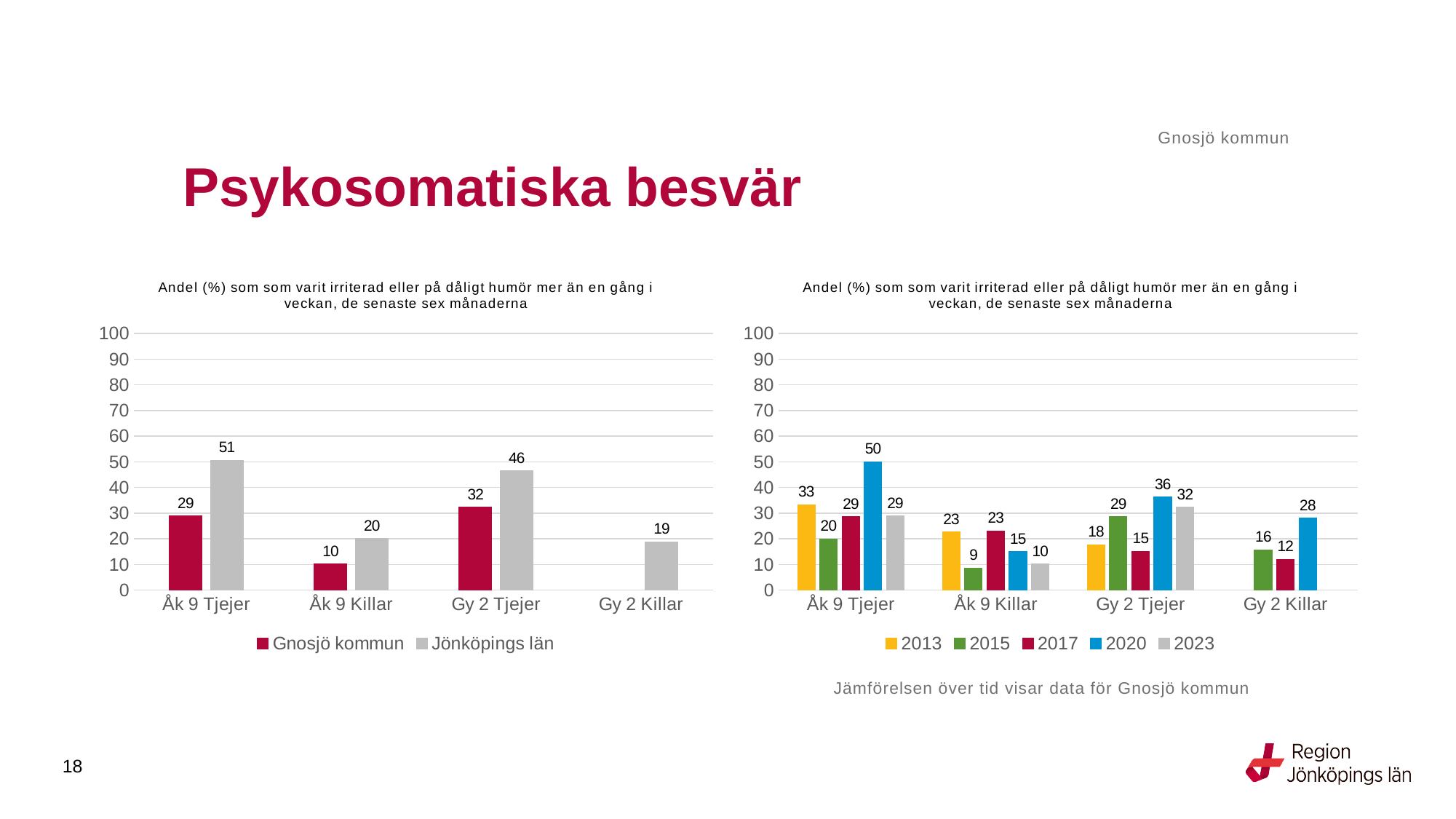
In the left chart, which category has the highest value for Jönköpings län? Åk 9 Tjejer In the right chart, what is the value for 2020 for Åk 9 Tjejer? 50 In the left chart, what is the value for Gnosjö kommun for Gy 2 Tjejer? 32 In the right chart, which is larger for Gy 2 Killar: 2015 or 2017? 2015 In the left chart, how many series does the legend list? 2 In the right chart, what is the value for 2015 for Åk 9 Killar? 9 In the left chart, is the Gnosjö kommun value for Åk 9 Killar greater or less than 20? less In the left chart, what is the difference between Jönköpings län and Gnosjö kommun for Åk 9 Tjejer? 22 What kind of chart is the right chart? Bar chart In the right chart, which year has the highest value for Gy 2 Tjejer? 2020 In the left chart, what is the value for Jönköpings län for Åk 9 Tjejer? 51 In the right chart, how many series does the legend list? 5